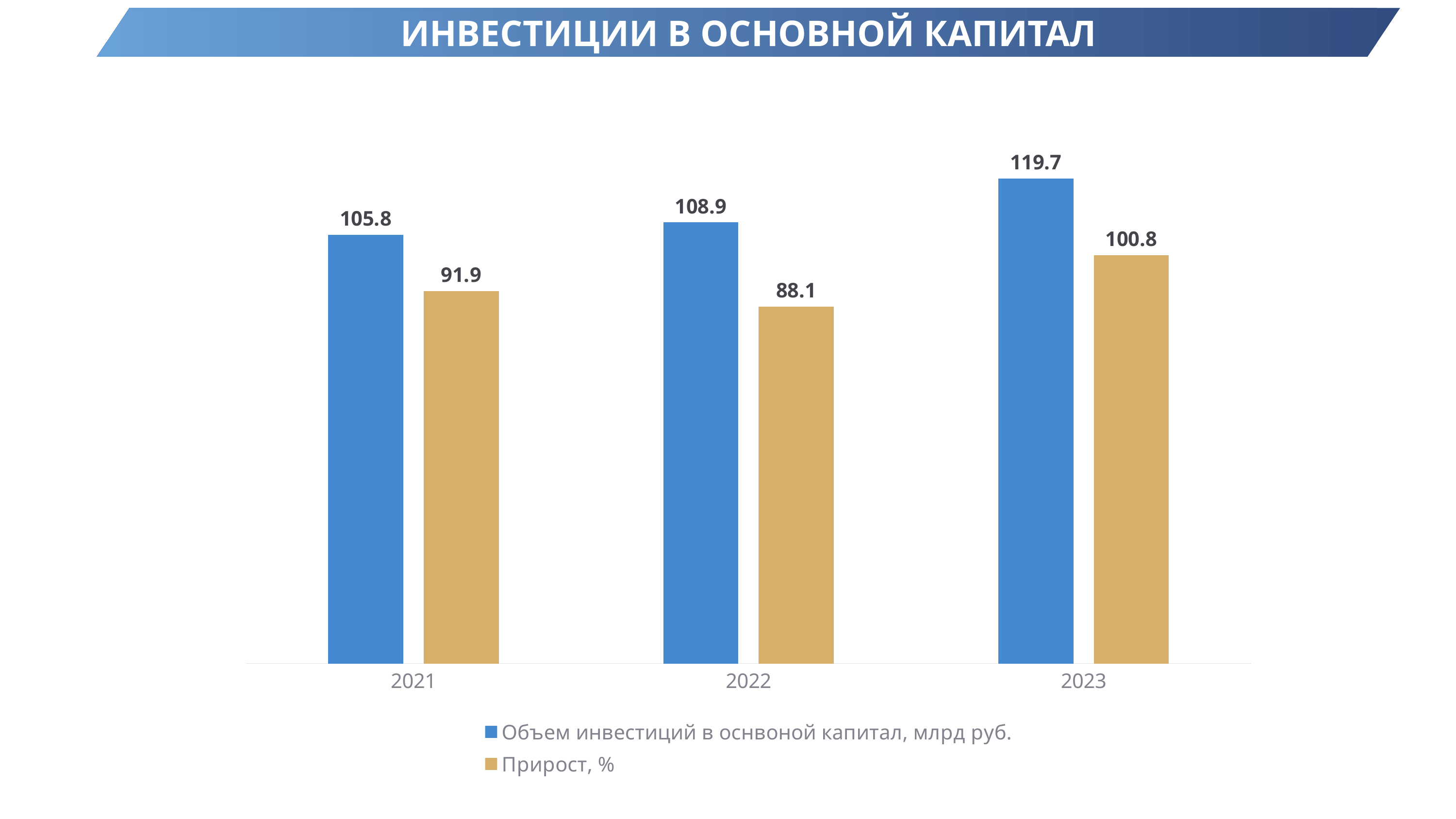
In which year is 'Прирост, %' the highest? 2023 What is the difference between the 'Объем инвестиций в основной капитал, млрд руб.' values for 2023 and 2022? 10.8 What kind of chart is shown on the slide? Bar chart What is the difference between the 'Прирост, %' values for 2021 and 2022? 3.8 How many series does the legend list? 2 Does 'Объем инвестиций в основной капитал, млрд руб.' rise or fall from 2021 to 2023? Rise What is the value of 'Прирост, %' for 2022? 88.1 Which is larger: 'Прирост, %' for 2021 or for 2023? 2023 In which year is 'Прирост, %' the lowest? 2022 What is the value of 'Объем инвестиций в основной капитал, млрд руб.' for 2021? 105.8 How many years are shown on the x axis? 3 What is the value of 'Объем инвестиций в основной капитал, млрд руб.' for 2023? 119.7